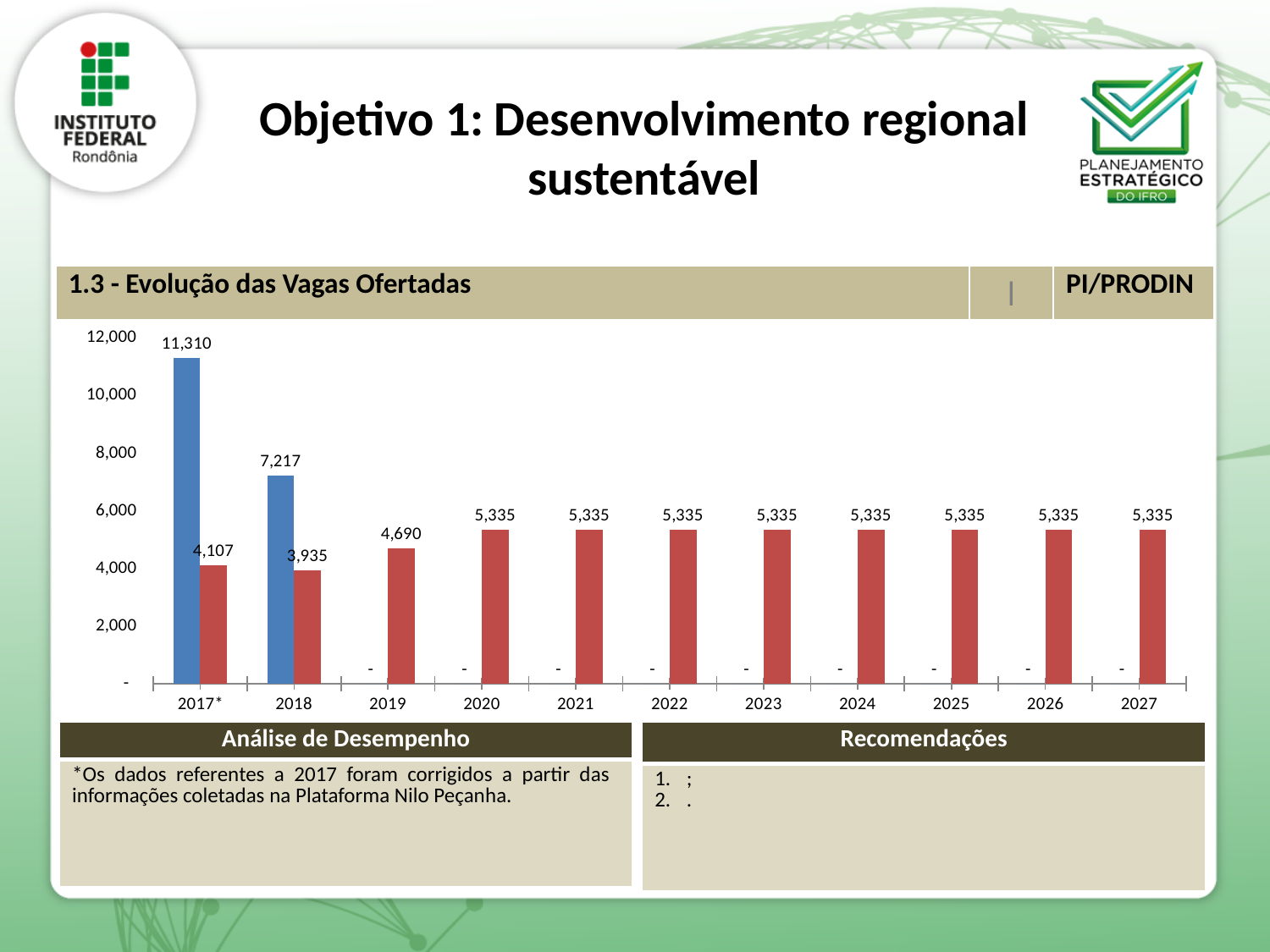
Which year has the lowest red bar? 2018 What is the value of the blue bar for 2017*? 11,310 What is the difference between the blue bar and the red bar for 2017*? 7,203 Which is larger, the red bar for 2019 or the red bar for 2020? 2020 What type of chart is shown on the slide? Bar chart How many years are shown on the x axis? 11 What is the title of the chart? 1.3 - Evolução das Vagas Ofertadas What is the value of the red bar for 2018? 3,935 What is the value of the red bar for 2019? 4,690 Which year has the highest bar in the chart? 2017* What is the value of the blue bar for 2018? 7,217 What is the difference between the blue bar values for 2017* and 2018? 4,093